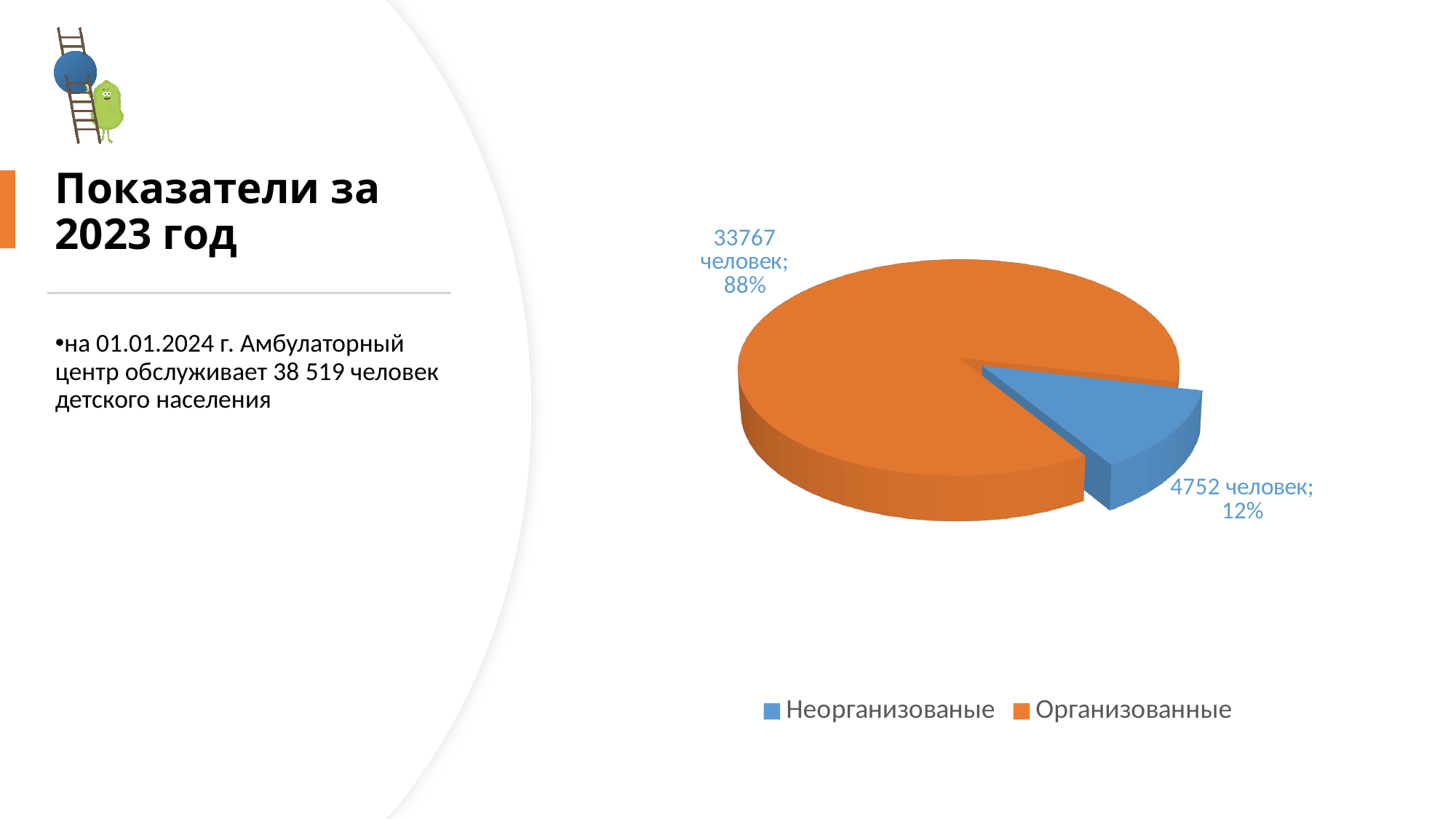
What kind of chart is shown on the slide? Pie chart Which slice of the pie chart is the largest? Организованные What share of the pie does the Организованные slice represent? 88% Which is larger, the Неорганизованые slice or the Организованные slice? Организованные What value is shown for the Неорганизованые slice? 4752 человек How many entries does the legend of the pie chart list? 2 What share of the pie does the Неорганизованые slice represent? 12% What is the difference between the Организованные and Неорганизованые values? 29015 человек How many slices does the pie chart have? 2 What value is shown for the Организованные slice? 33767 человек What colour is the Неорганизованые slice in the pie chart? Blue Which slice of the pie chart is the smallest? Неорганизованые